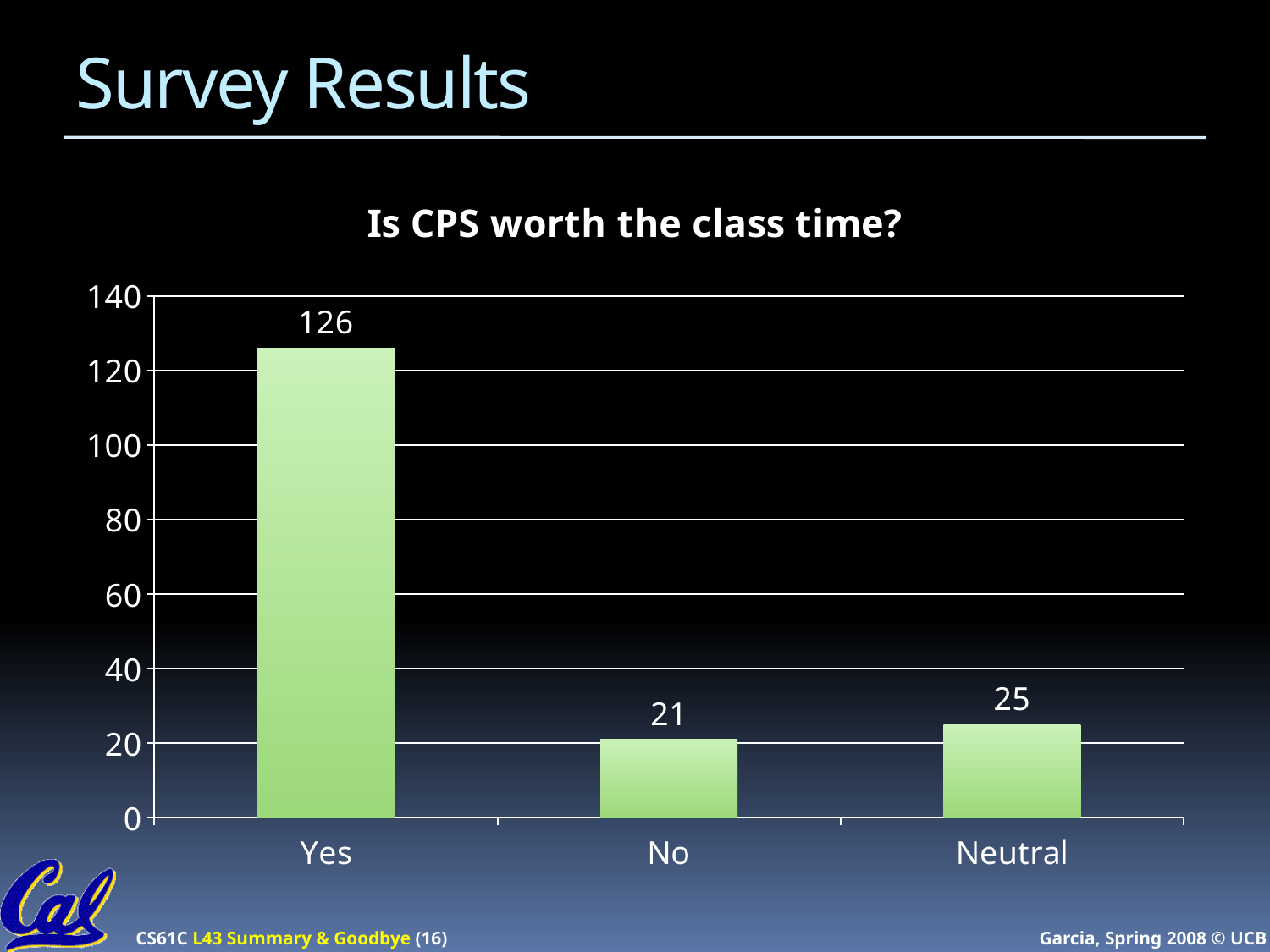
What is the value for Yes? 126 Is the value for Yes greater or less than 120? greater Which category has the highest value? Yes How many categories are shown on the x axis? 3 Which is larger, the value for No or the value for Neutral? Neutral What is the value for No? 21 What is the title of the chart? Is CPS worth the class time? What kind of chart is shown on the slide? bar chart Which category has the lowest value? No What is the value for Neutral? 25 What is the difference between the values for Yes and Neutral? 101 What is the difference between the values for Neutral and No? 4